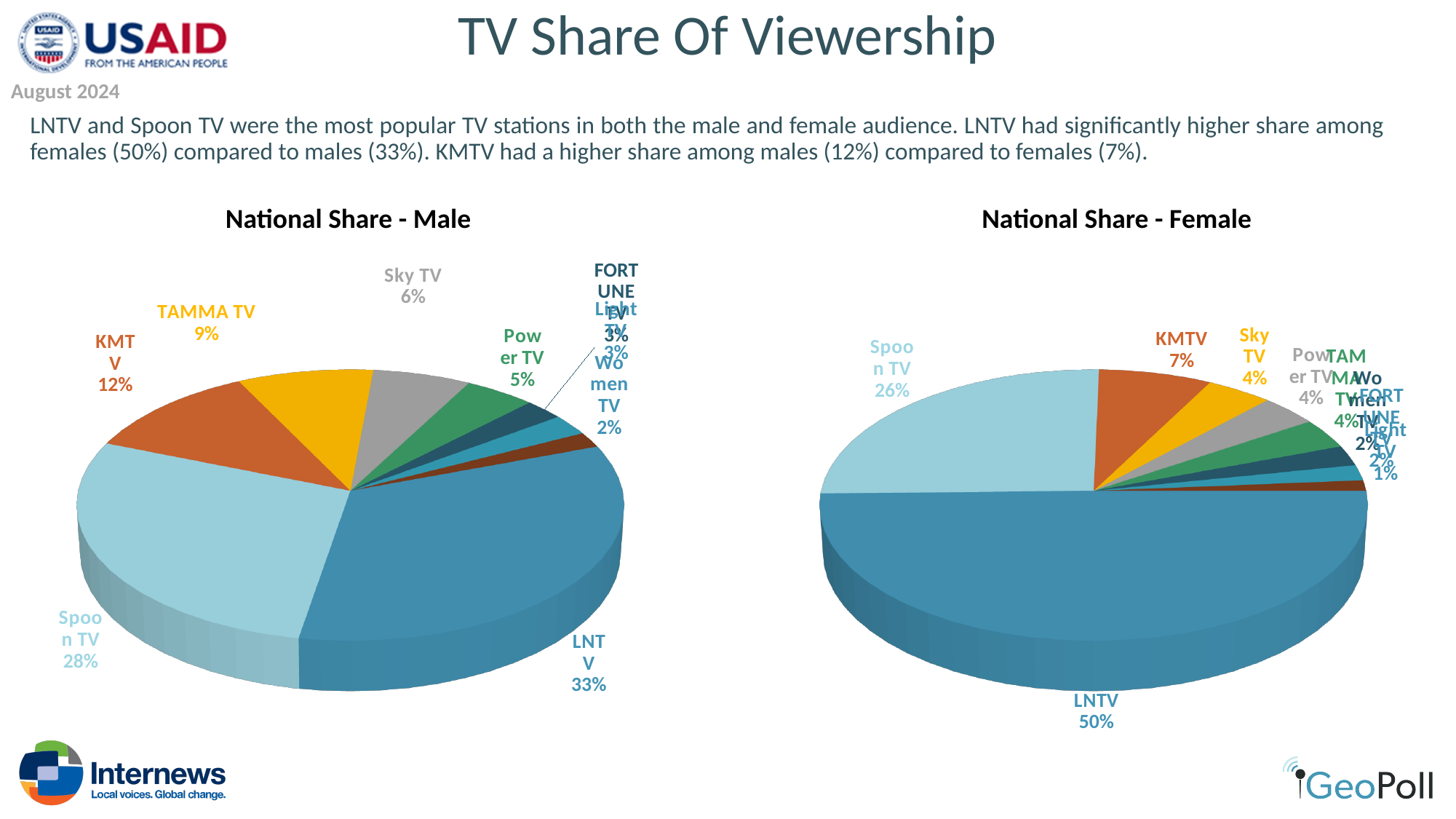
In the National Share - Female chart, what is the difference between the LNTV share and the Spoon TV share? 24 percentage points In the National Share - Male chart, what share does LNTV have? 33% In the National Share - Female chart, what share does Spoon TV have? 26% In the National Share - Male chart, what share does Spoon TV have? 28% In the National Share - Female chart, what share does KMTV have? 7% What type of chart is the National Share - Male chart? Pie chart In the National Share - Male chart, which station has the largest share? LNTV In the National Share - Male chart, what share does TAMMA TV have? 9% In the National Share - Male chart, what is the difference between the LNTV share and the Spoon TV share? 5 percentage points In the National Share - Female chart, what share does LNTV have? 50% Is the KMTV share larger in the National Share - Male chart or the National Share - Female chart? National Share - Male In the National Share - Male chart, what share does KMTV have? 12%